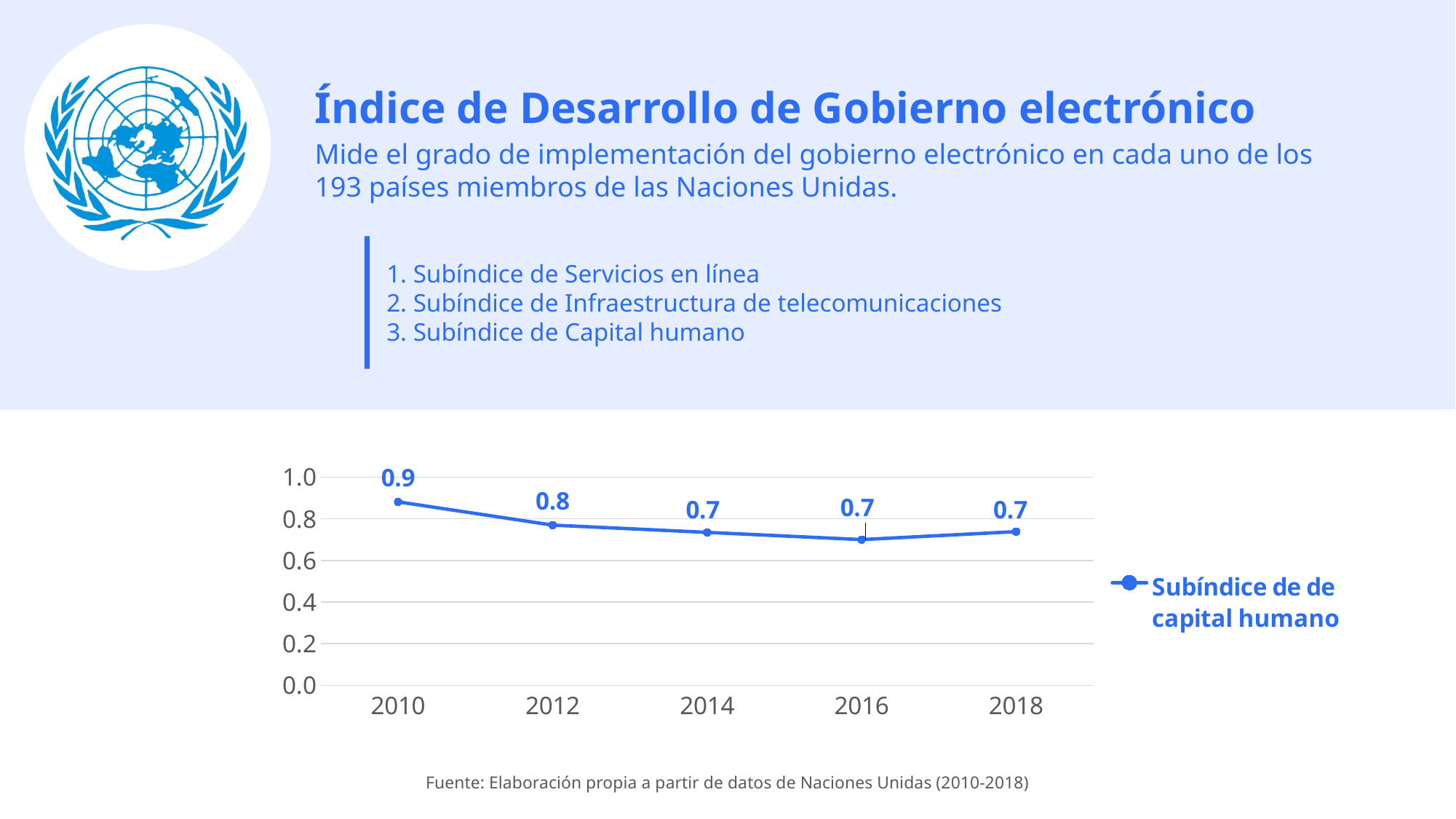
How many series does the legend list? 1 Which year has the highest value? 2010 Which is larger, the value for 2010 or the value for 2014? 2010 What is the difference between the values for 2010 and 2012? 0.1 What is the value for 2018? 0.7 What kind of chart is shown? line chart What is the value for 2012? 0.8 Is the value for 2016 greater or less than 0.8? less Is the value for 2010 greater or less than 0.8? greater What is the value for 2010? 0.9 What series name does the legend show? Subíndice de de capital humano How many years are plotted on the chart? 5